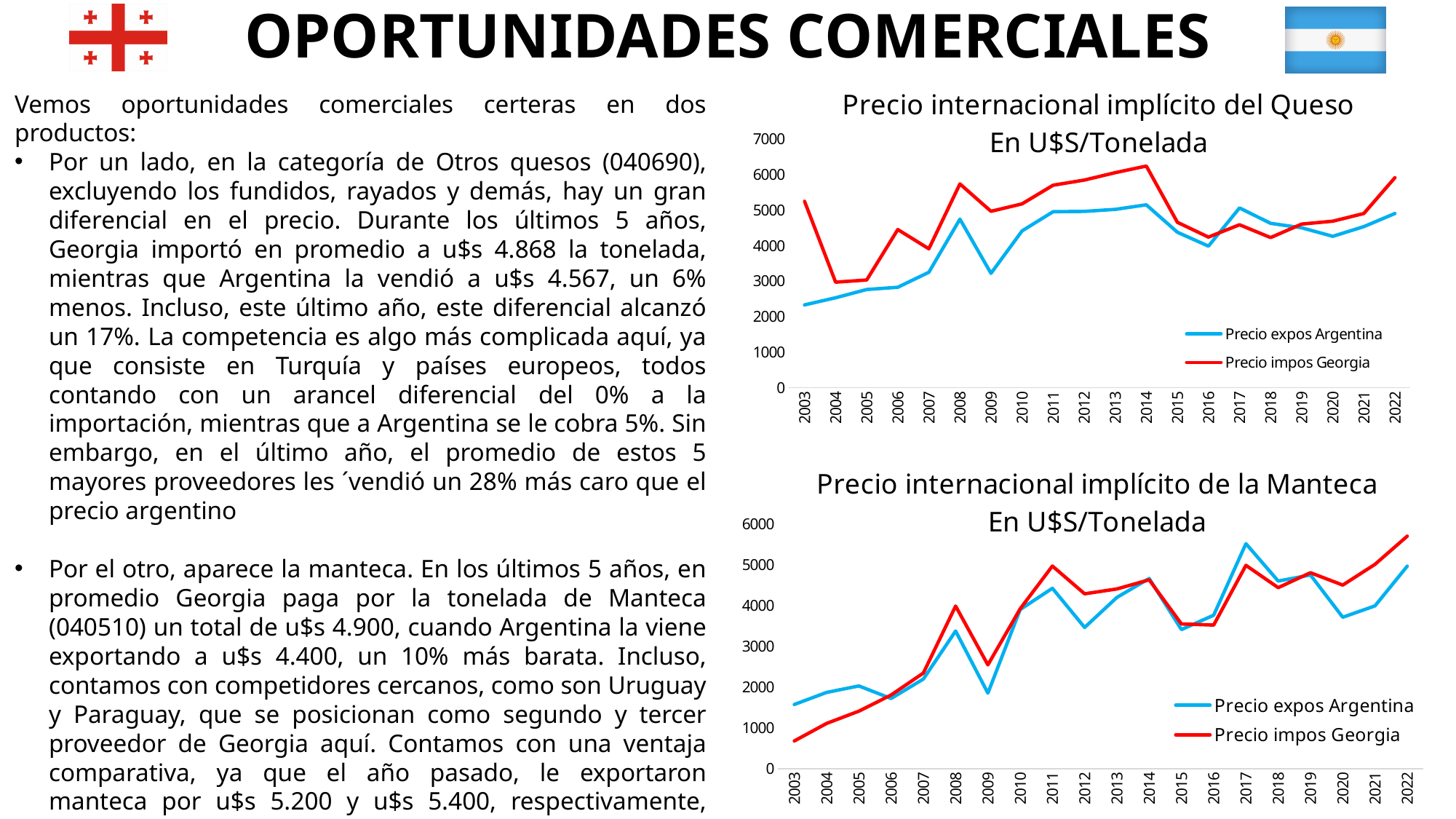
What kind of chart is the 'Precio internacional implícito del Queso' chart? line chart In the 'Precio internacional implícito de la Manteca' chart, in which year is Precio impos Georgia highest? 2022 How many series does the legend of the 'Precio internacional implícito de la Manteca' chart list? 2 In the 'Precio internacional implícito de la Manteca' chart, is the value for Precio impos Georgia in 2003 greater or less than 1000? less In the 'Precio internacional implícito de la Manteca' chart, does Precio expos Argentina overall rise or fall from 2003 to 2022? rise In the 'Precio internacional implícito del Queso' chart, is the value for Precio impos Georgia in 2003 greater or less than 5000? greater In the 'Precio internacional implícito del Queso' chart, is the value for Precio expos Argentina in 2003 greater or less than 3000? less In the 'Precio internacional implícito de la Manteca' chart, in which year is Precio expos Argentina highest? 2017 In the 'Precio internacional implícito de la Manteca' chart, which series has the larger value in 2022, Precio expos Argentina or Precio impos Georgia? Precio impos Georgia In the 'Precio internacional implícito del Queso' chart, which series has the larger value in 2008, Precio expos Argentina or Precio impos Georgia? Precio impos Georgia How many years are shown on the x axis of the 'Precio internacional implícito del Queso' chart? 20 In the 'Precio internacional implícito del Queso' chart, in which year is Precio expos Argentina lowest? 2003